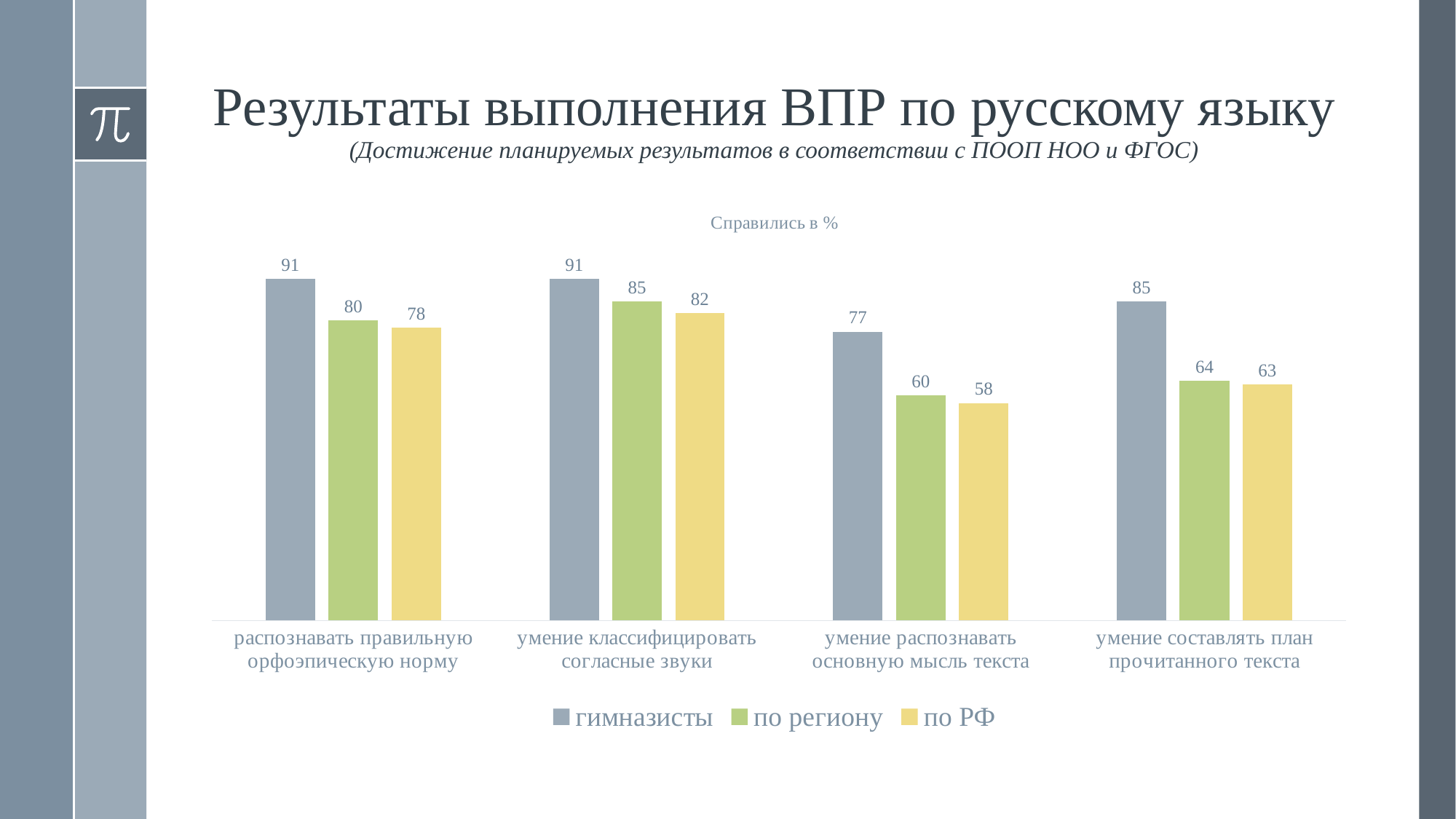
What is the value for гимназисты in the category 'умение распознавать основную мысль текста'? 77 What is the value for по региону in the category 'умение составлять план прочитанного текста'? 64 Which category has the highest value for по региону? умение классифицировать согласные звуки What kind of chart is shown on the slide? bar chart Which category has the lowest value for по РФ? умение распознавать основную мысль текста What is the title of the chart? Справились в % What is the value for по РФ in the category 'умение классифицировать согласные звуки'? 82 How many series does the legend list? 3 How many categories are shown on the x axis? 4 Which is larger: по региону in 'умение составлять план прочитанного текста' or по РФ in 'распознавать правильную орфоэпическую норму'? по РФ in 'распознавать правильную орфоэпическую норму' What is the difference between гимназисты and по РФ in the category 'умение распознавать основную мысль текста'? 19 What is the difference between гимназисты and по региону in the category 'распознавать правильную орфоэпическую норму'? 11